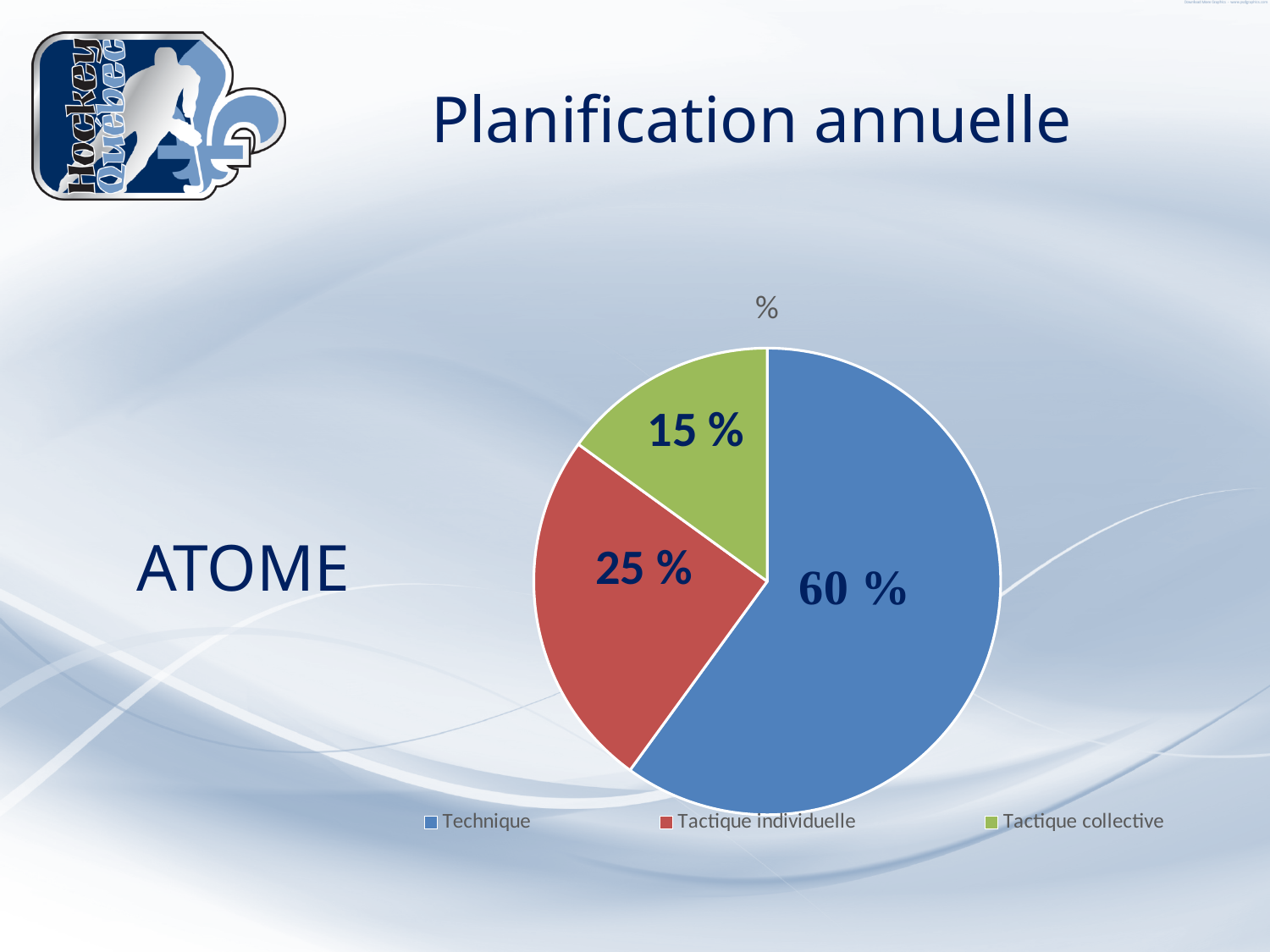
How many slices does the pie chart have? 3 What is the difference between the values for Technique and Tactique individuelle? 35 % Which category has the smallest slice? Tactique collective What is the value for Tactique collective? 15 % What is the title shown above the pie chart? % What is the value for Tactique individuelle? 25 % What colour is the Technique slice? blue Which category has the largest slice? Technique Which is larger, Tactique individuelle or Tactique collective? Tactique individuelle What is the value for Technique? 60 % What is the difference between the values for Tactique individuelle and Tactique collective? 10 % What kind of chart is shown on the slide? pie chart